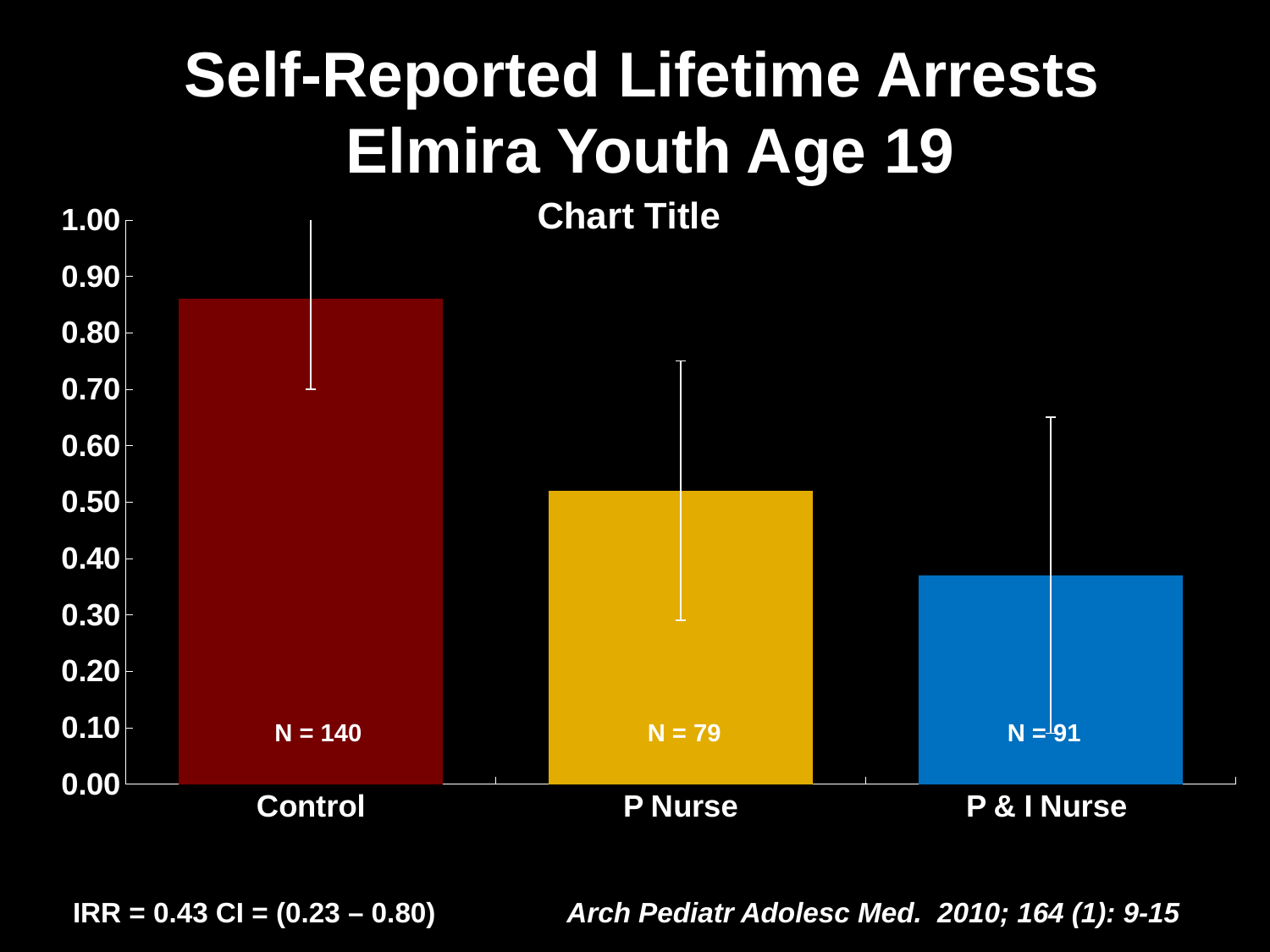
Is the value for P Nurse greater or less than 0.60? less What kind of chart is shown on the slide? bar chart Is the value for Control greater or less than 0.80? greater What sample size (N) is printed on the Control bar? N = 140 Is the value for P & I Nurse greater or less than 0.40? less What sample size (N) is printed on the P & I Nurse bar? N = 91 Do the bar values rise or fall from left to right across the x axis? fall What colour is the P Nurse bar? yellow How many categories are plotted on the x axis? 3 Which bar is taller, P Nurse or P & I Nurse? P Nurse Which category has the highest bar? Control Which category has the lowest bar? P & I Nurse